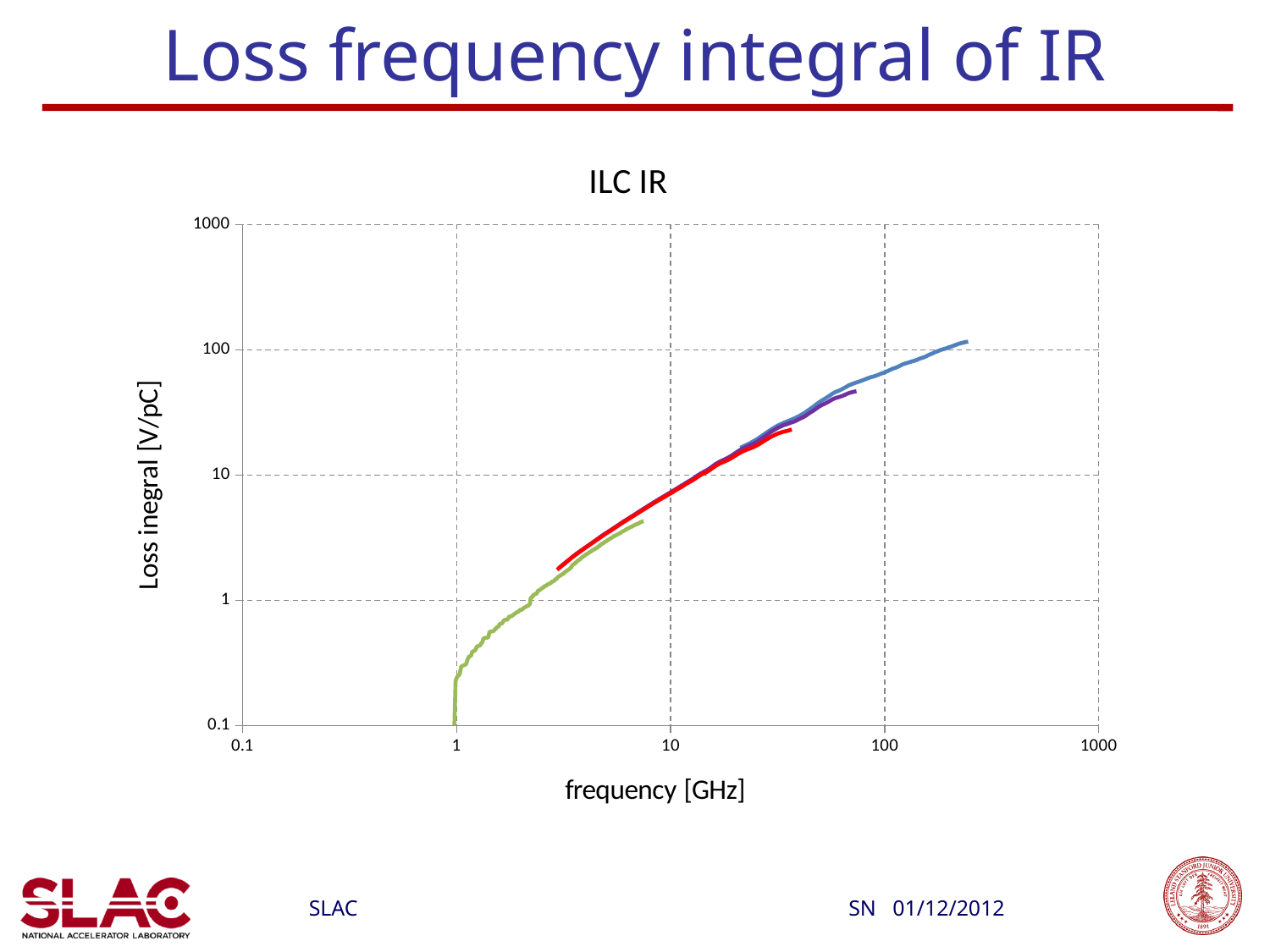
Is the value of the red line at 10 GHz greater or less than 10 V/pC? less Is the value of the green line at 1 GHz greater or less than 1 V/pC? less Is the highest value reached by the blue line greater or less than 10 V/pC? greater Which line reaches the highest loss integral value on the chart? the blue line What kind of chart is shown on the slide? line chart Do the plotted values rise or fall as frequency increases? rise Which line extends to a higher frequency, the blue line or the purple line? the blue line What is the title of the chart? ILC IR Which line starts at the lowest frequency on the chart? the green line